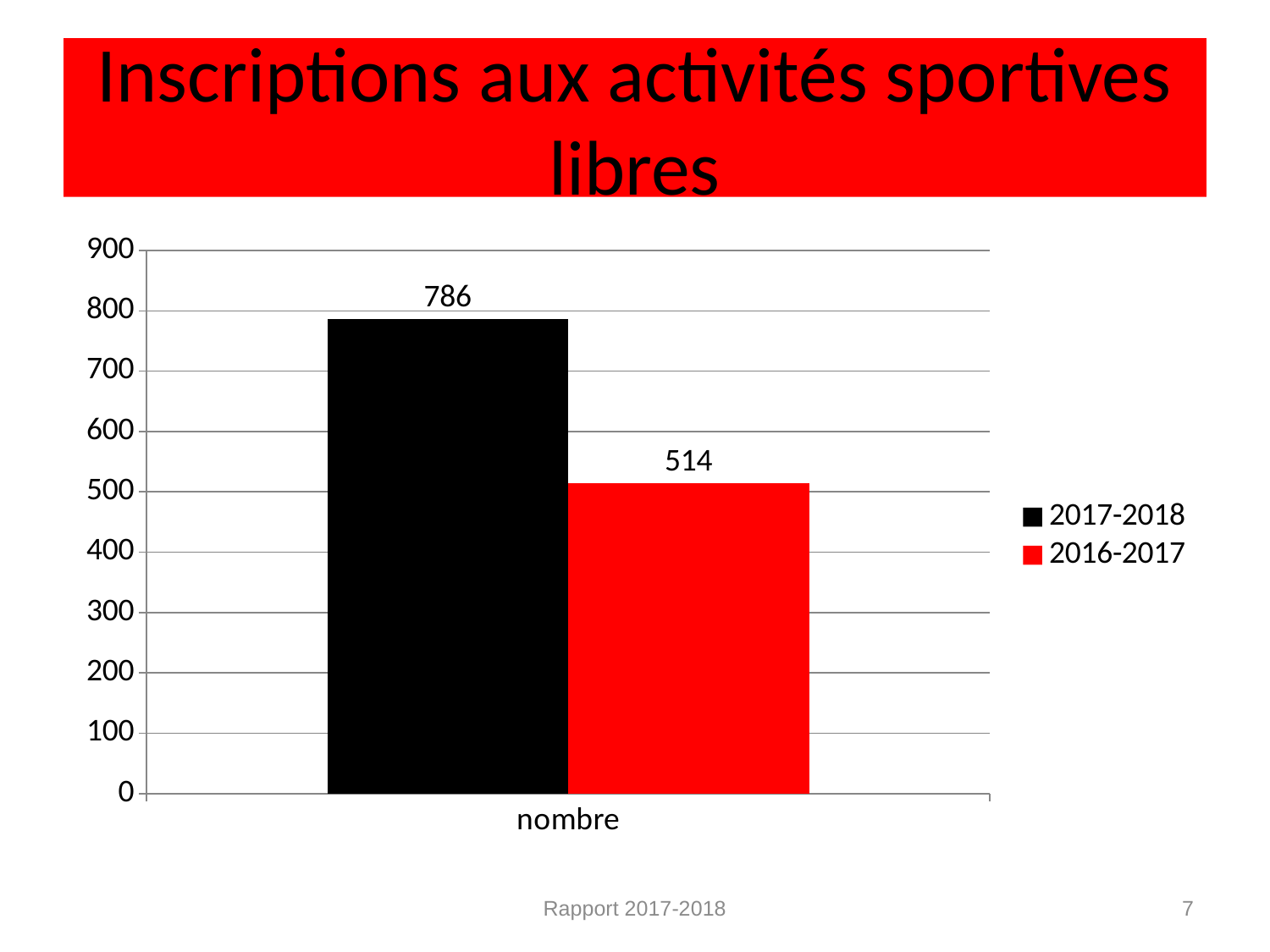
What is the value for 2017-2018? 786 What colour is the bar for 2016-2017? red What is the value for 2016-2017? 514 Which series has the lower value? 2016-2017 Is the value for 2017-2018 greater or less than 700? greater How many series does the legend list? 2 What is the category label on the x axis? nombre Which series has the higher value? 2017-2018 What kind of chart is shown on the slide? bar chart Is the value for 2016-2017 greater or less than 600? less Is the value for 2017-2018 larger or smaller than the value for 2016-2017? larger What is the difference between the 2017-2018 value and the 2016-2017 value? 272